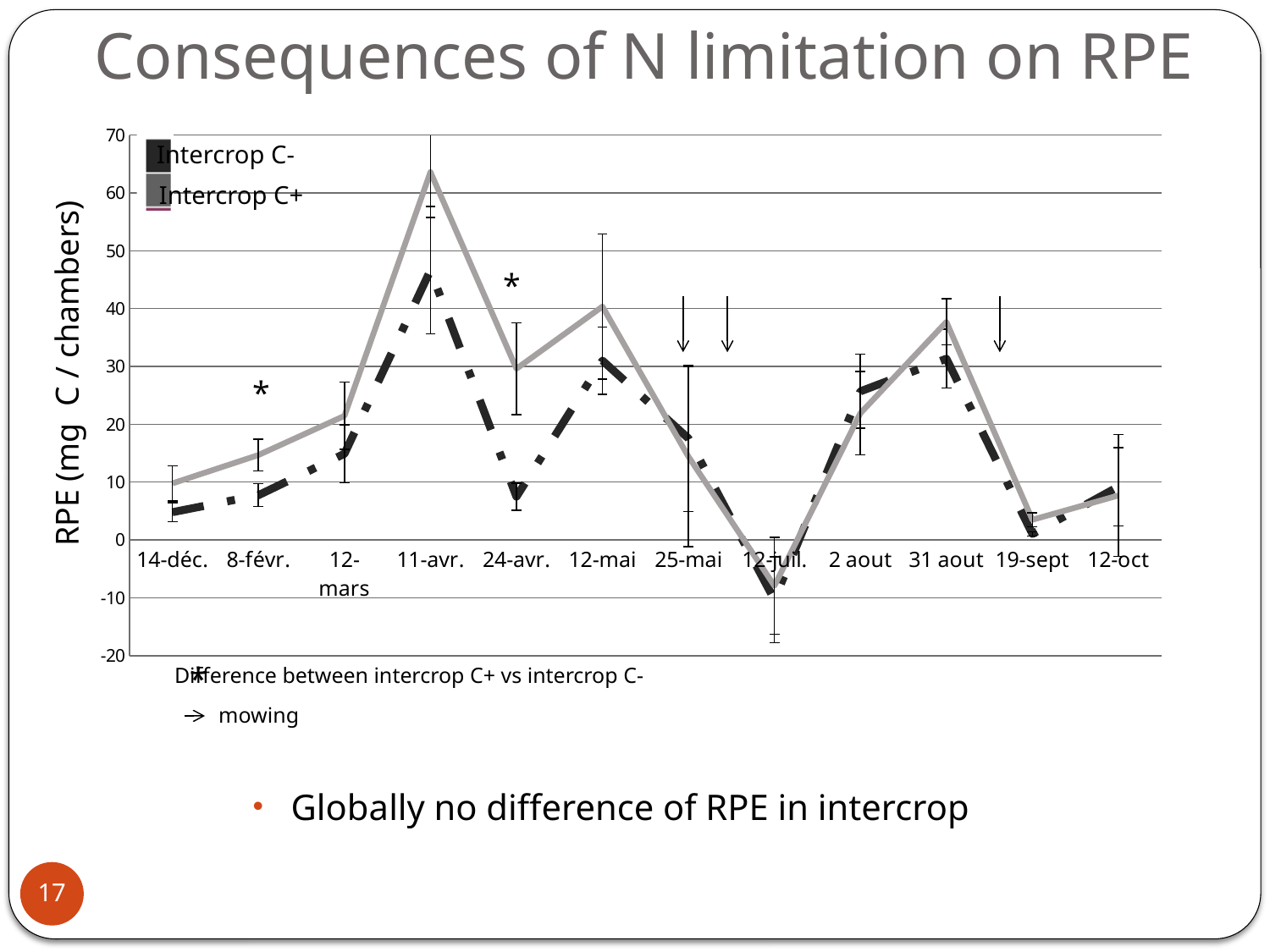
Is the value for Intercrop C- on 12-juil. greater or less than 0? less On which date does the Intercrop C- series reach its lowest value? 12-juil. Is the value for Intercrop C- on 24-avr. greater or less than 20? less Does the Intercrop C+ series rise or fall from 14-déc. to 11-avr.? rise On 24-avr., which series has the larger value, Intercrop C+ or Intercrop C-? Intercrop C+ How many dates are shown on the x axis? 12 What is the label of the y axis? RPE (mg C / chambers) What kind of chart is shown on the slide? line chart Is the value for Intercrop C+ on 11-avr. greater or less than 50? greater On which date does the Intercrop C+ series reach its highest value? 11-avr. How many series does the legend list? 2